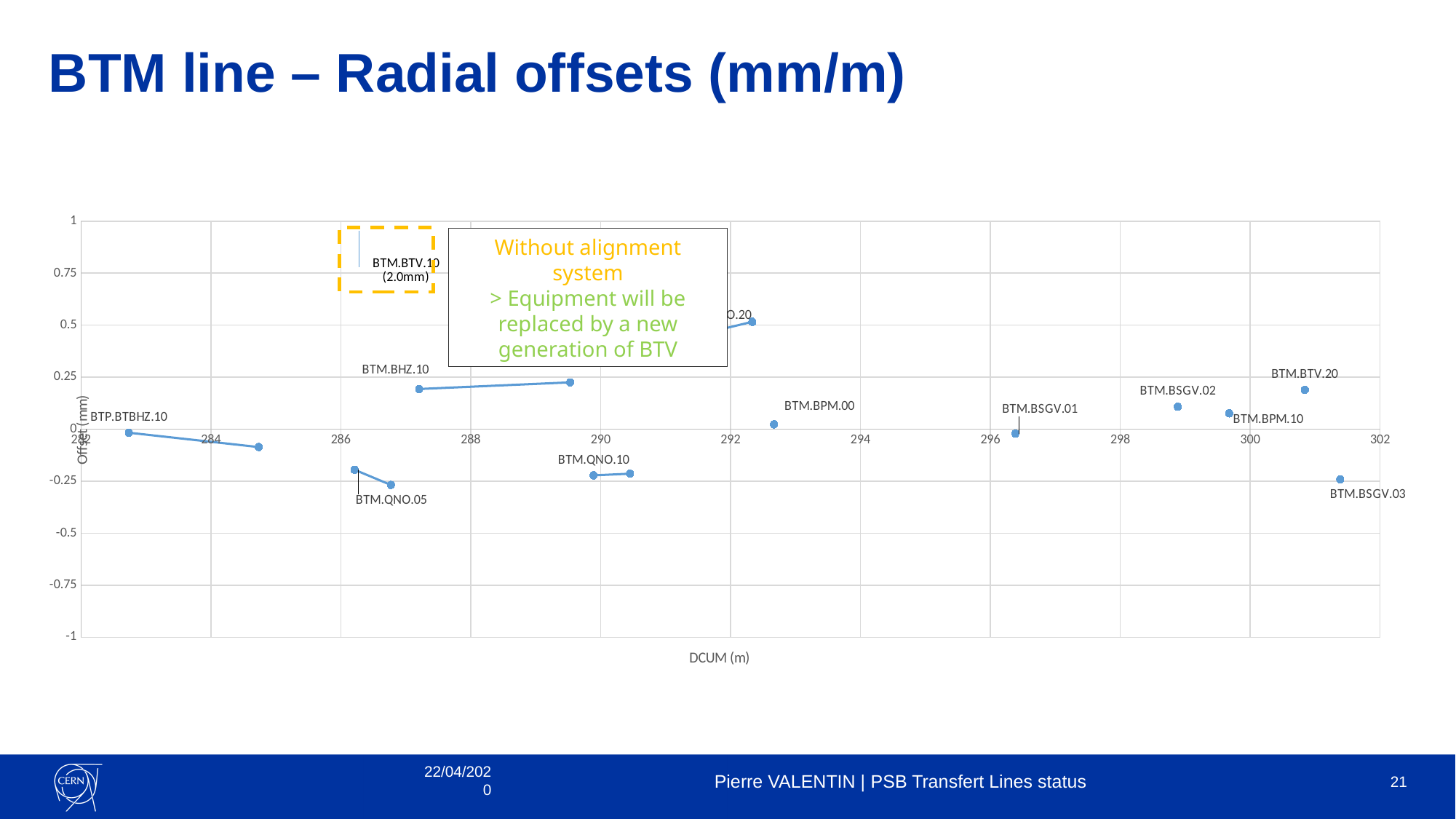
Is the offset plotted for BTM.BHZ.10 greater or less than 0? greater What is the label of the y axis of the chart? Offset (mm) What offset value is noted next to BTM.BTV.10 in the dashed box? 2.0mm Is the offset plotted for BTM.BTV.20 greater or less than 0.25? less Is the offset plotted for BTM.QNO.05 greater or less than 0? less What is the label of the x axis of the chart? DCUM (m) Which has the larger plotted offset, BTM.BTV.20 or BTM.BSGV.03? BTM.BTV.20 What kind of chart is shown on the slide? scatter chart